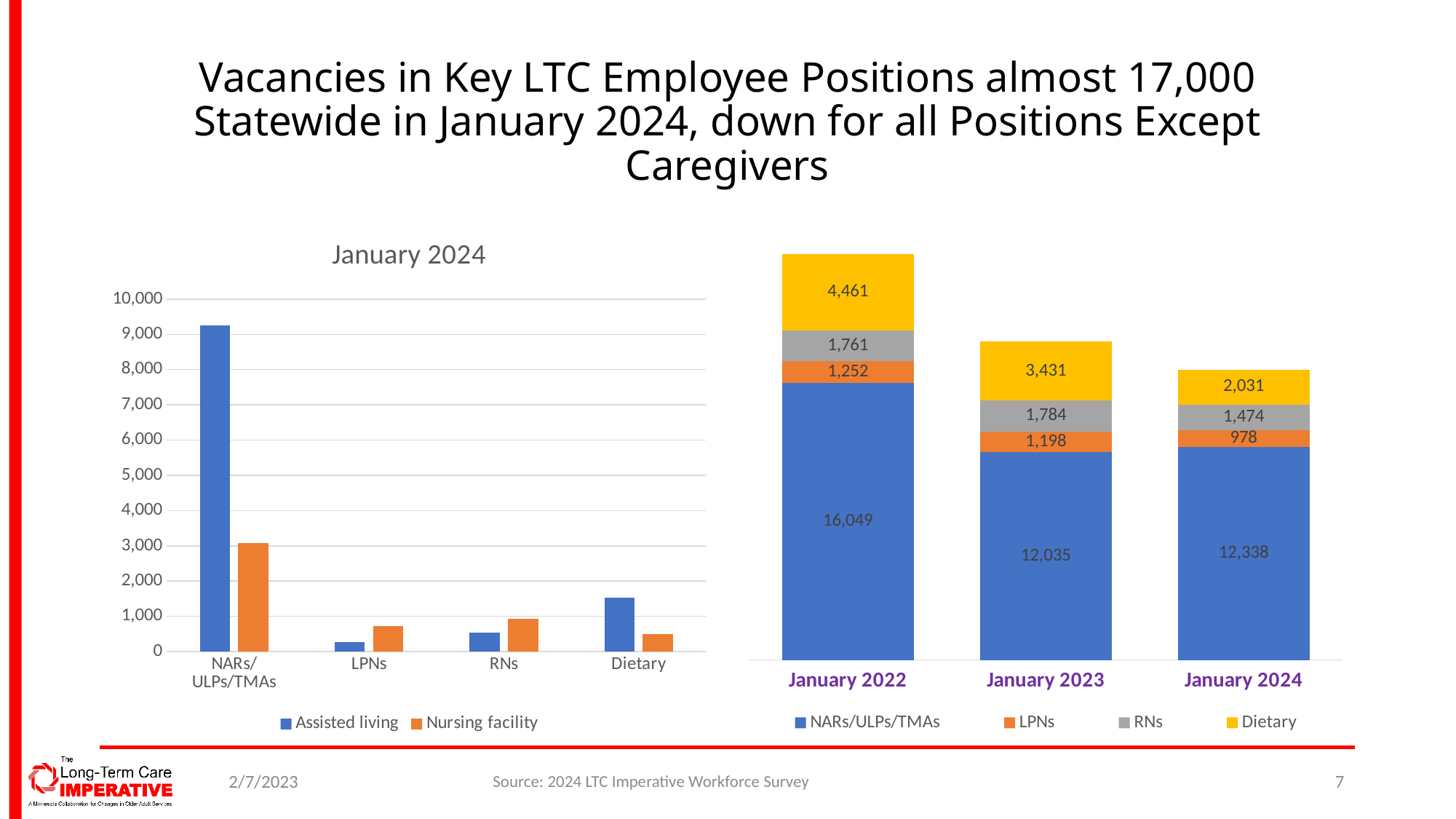
On the left-hand 'January 2024' chart, is the Assisted living or Nursing facility value larger for Dietary? Assisted living On the left-hand 'January 2024' chart, is the Assisted living value for NARs/ULPs/TMAs greater or less than 9,000? greater On the right-hand stacked bar chart, which year has the highest value for RNs? January 2023 On the right-hand stacked bar chart, what is the value for NARs/ULPs/TMAs in January 2022? 16,049 On the right-hand stacked bar chart, is the LPNs value larger in January 2022 or January 2024? January 2022 On the right-hand stacked bar chart, what is the value for Dietary in January 2024? 2,031 On the left-hand 'January 2024' chart, which category has the highest Nursing facility value? NARs/ULPs/TMAs On the right-hand stacked bar chart, what is the total of the January 2024 bar? 16,821 On the right-hand stacked bar chart, what is the difference between the Dietary values for January 2022 and January 2024? 2,430 How many series does the legend of the right-hand stacked bar chart list? 4 On the right-hand stacked bar chart, what is the value for LPNs in January 2023? 1,198 How many categories are shown on the x axis of the left-hand 'January 2024' chart? 4